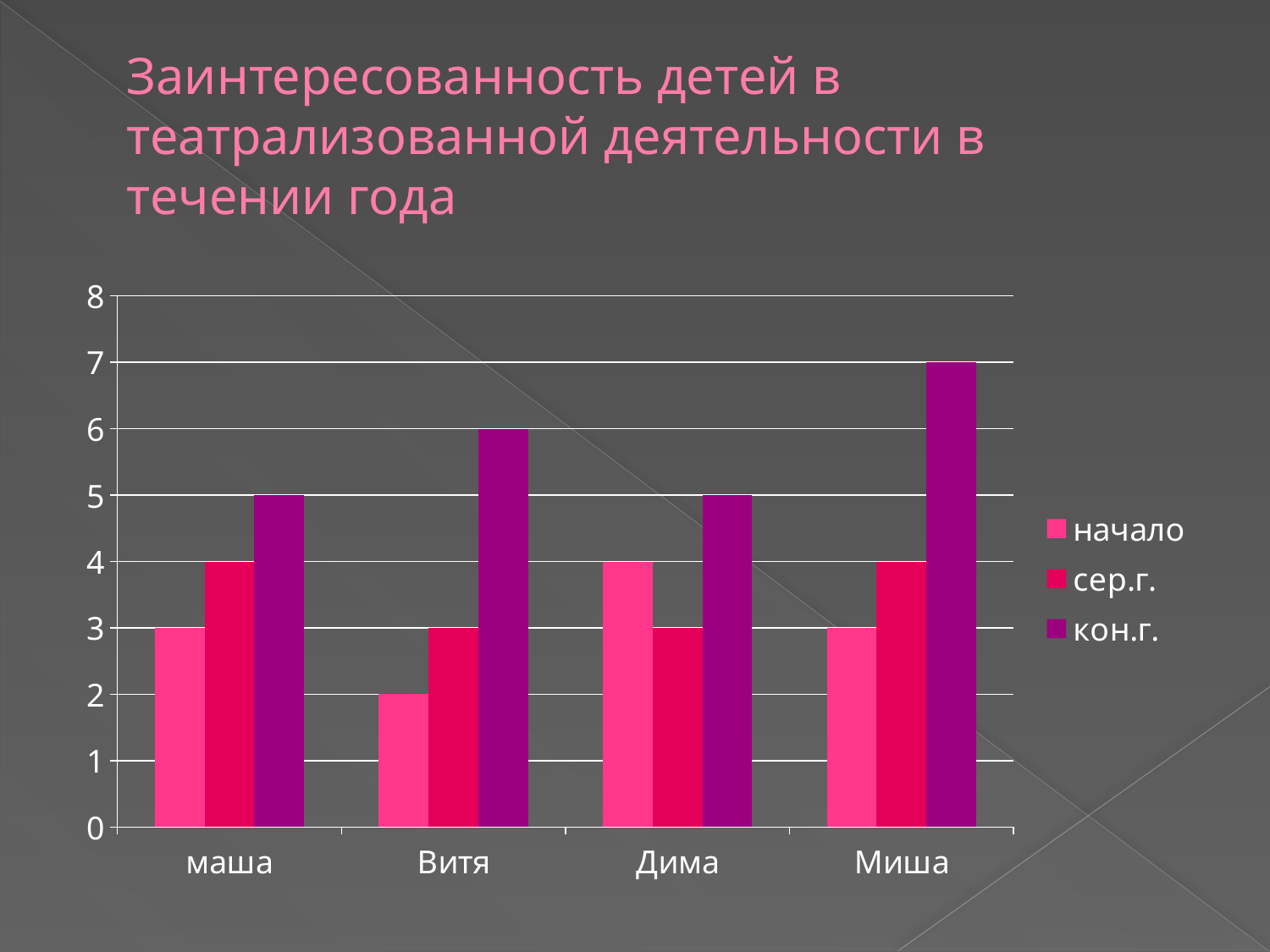
For маша, do the values rise or fall from начало to кон.г.? rise Which series is shown in the darkest purple colour? кон.г. What kind of chart is shown on the slide? bar chart What is the difference between the кон.г. and начало values for Витя? 4 What is the value for Витя in the начало series? 2 How many categories (children) are shown on the x axis? 4 How many series does the legend list? 3 Which is larger for Дима: the начало value or the сер.г. value? начало Which child has the lowest value in the начало series? Витя Which child has the highest value in the кон.г. series? Миша What is the value for Миша in the кон.г. series? 7 What is the value for Дима in the сер.г. series? 3